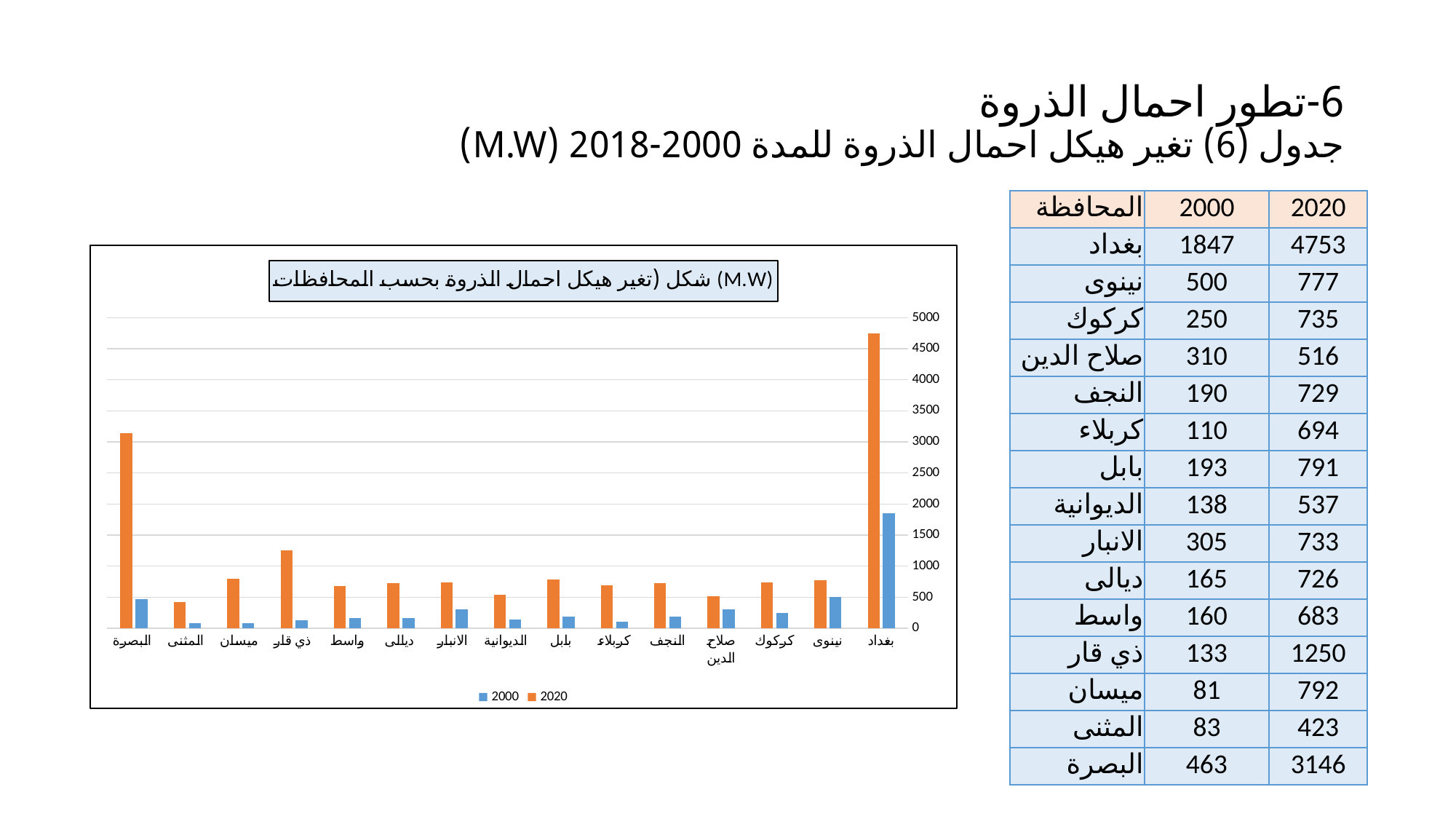
Which province has the highest 2000 value in the chart? بغداد Which province has the lowest 2020 value in the chart? المثنى How many series does the chart's legend list? 2 Which colour represents the 2020 series in the chart? orange Which province has the highest 2020 value in the chart? بغداد According to the table, what is the 2020 value for بغداد? 4753 What kind of chart is shown on the slide? bar chart Is the 2020 value for البصرة greater or less than 3000? greater How many provinces (categories) are plotted on the x axis of the chart? 15 According to the table, what is the difference between the 2020 and 2000 values for بغداد? 2906 Which is larger, the 2020 value for ذي قار or the 2020 value for ميسان? ذي قار Is the 2020 value for ذي قار greater or less than 1000? greater